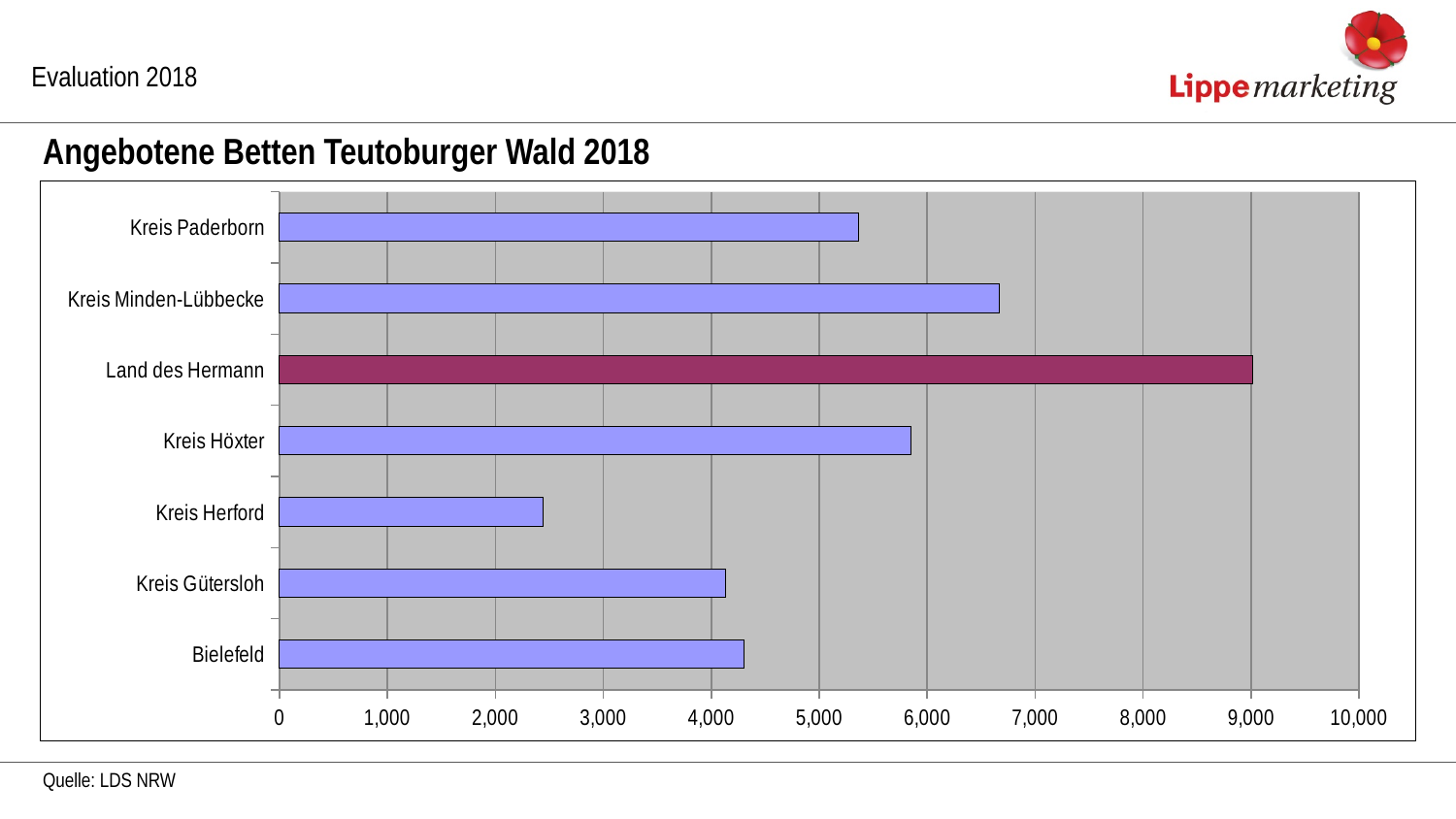
Is the value for Kreis Paderborn greater or less than 6,000? less Is the value for Kreis Herford greater or less than 3,000? less What type of chart is shown on the slide? bar chart Is the value for Bielefeld greater or less than 4,000? greater Which has a larger value, Kreis Minden-Lübbecke or Kreis Paderborn? Kreis Minden-Lübbecke Which category has the lowest value? Kreis Herford How many categories are shown in the chart? 7 Which category has the highest value? Land des Hermann Which has a larger value, Kreis Höxter or Kreis Herford? Kreis Höxter What is the title of the chart? Angebotene Betten Teutoburger Wald 2018